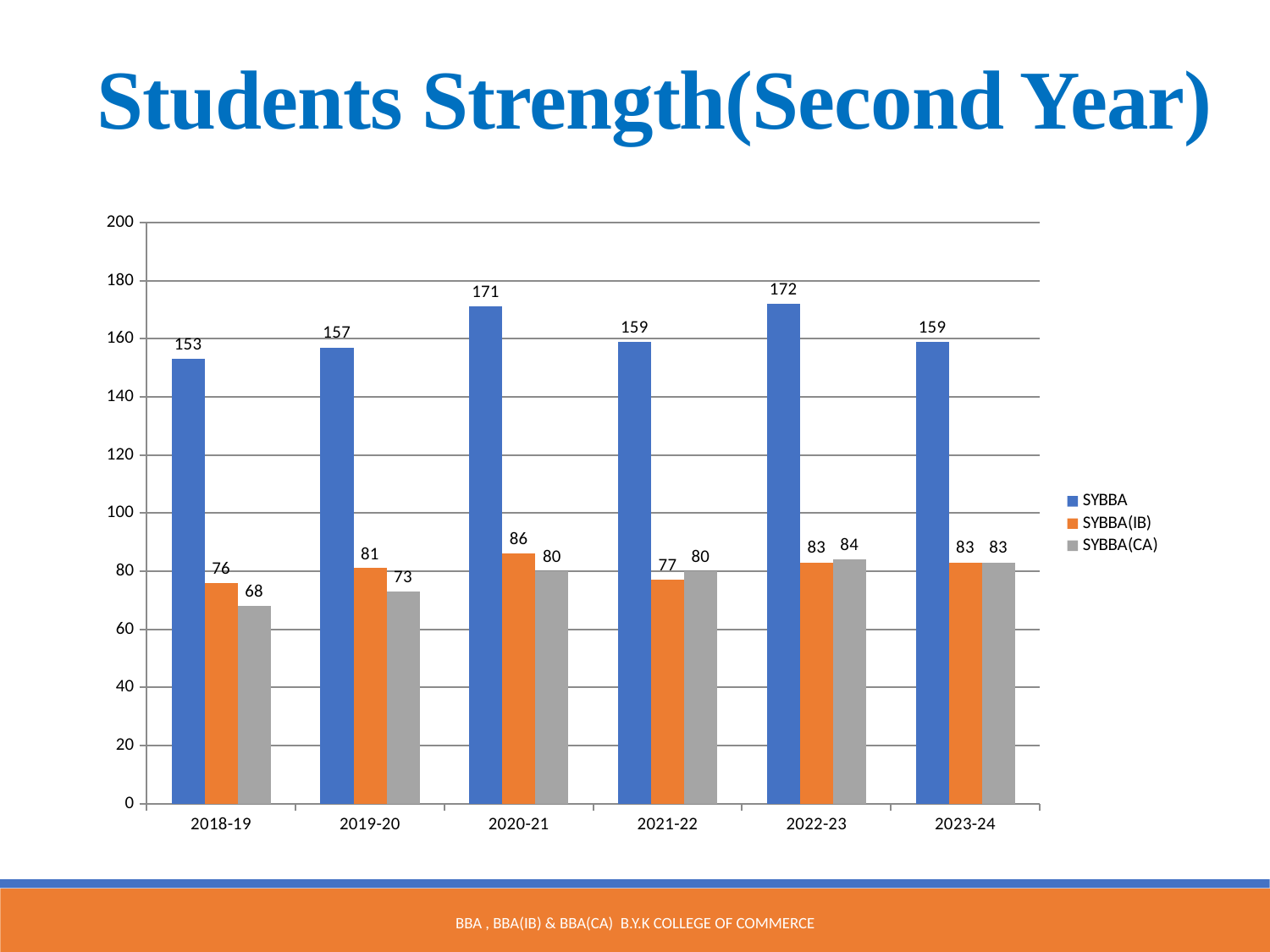
What kind of chart is shown on the slide? Bar chart Does the SYBBA(IB) value rise or fall from 2018-19 to 2020-21? Rise What is the difference between the SYBBA values for 2022-23 and 2018-19? 19 What is the title of the slide? Students Strength(Second Year) How many years are shown on the x axis? 6 How many series does the legend list? 3 In which year is the SYBBA(CA) value lowest? 2018-19 What is the SYBBA(CA) value for 2018-19? 68 What is the SYBBA value for 2020-21? 171 Which is larger in 2019-20, SYBBA(IB) or SYBBA(CA)? SYBBA(IB) In which year is the SYBBA value highest? 2022-23 What is the SYBBA(IB) value for 2021-22? 77